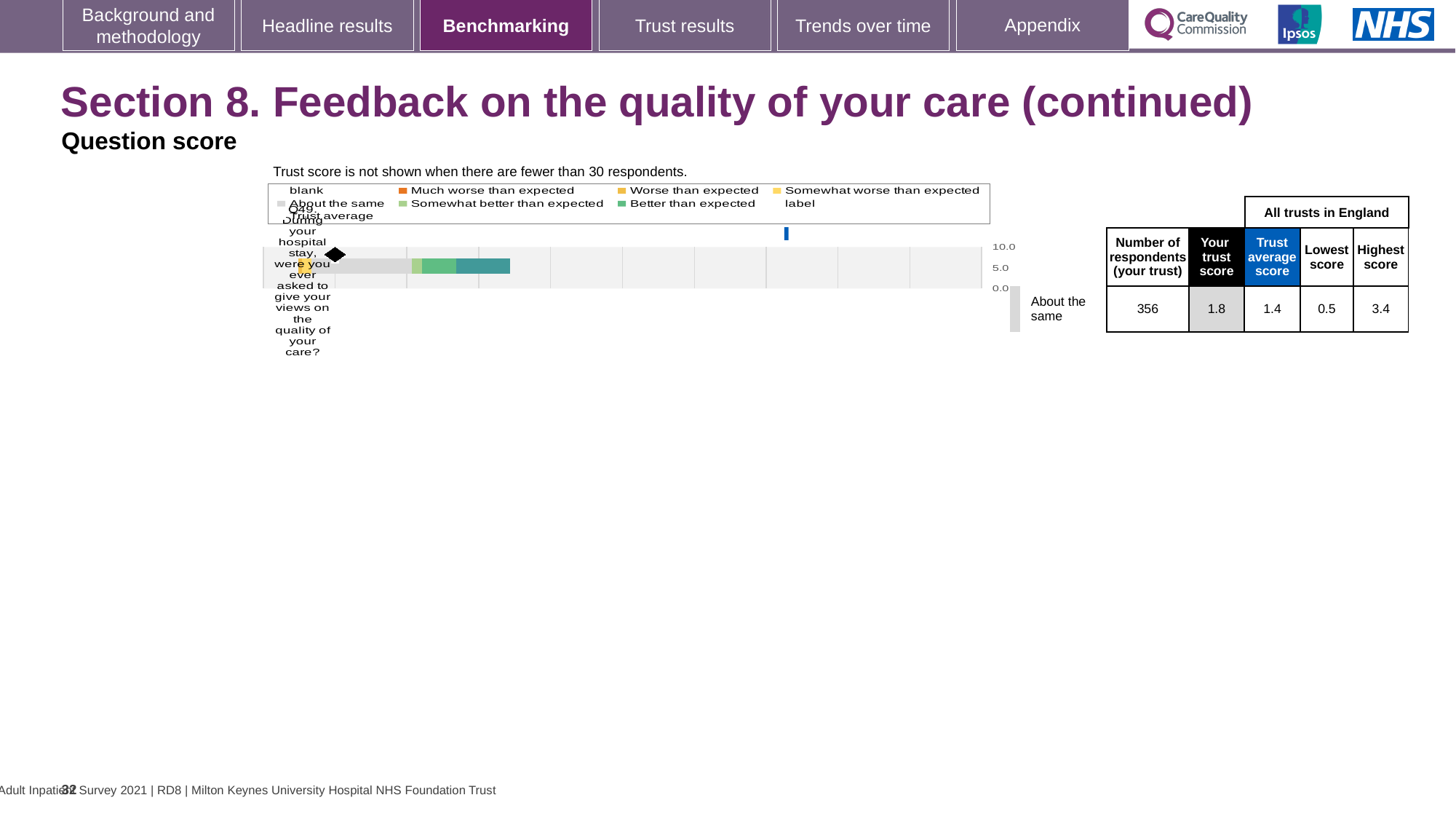
How many respondents from the trust answered Q49? 356 How is the trust's result for Q49 categorised relative to expectations? About the same What is the difference between the highest and lowest scores across all trusts in England for Q49? 2.9 Which question is plotted in the chart? Q49. During your hospital stay, were you ever asked to give your views on the quality of your care? What is the highest score across all trusts in England for Q49? 3.4 What kind of chart is shown on the slide? Bar chart Is the trust score for Q49 greater or less than 5.0? less What is the lowest score across all trusts in England for Q49? 0.5 What is the trust score for Q49? 1.8 Which is larger for Q49, the trust score or the trust average score? Trust score How many questions are plotted in the chart? 1 What is the trust average score for Q49? 1.4